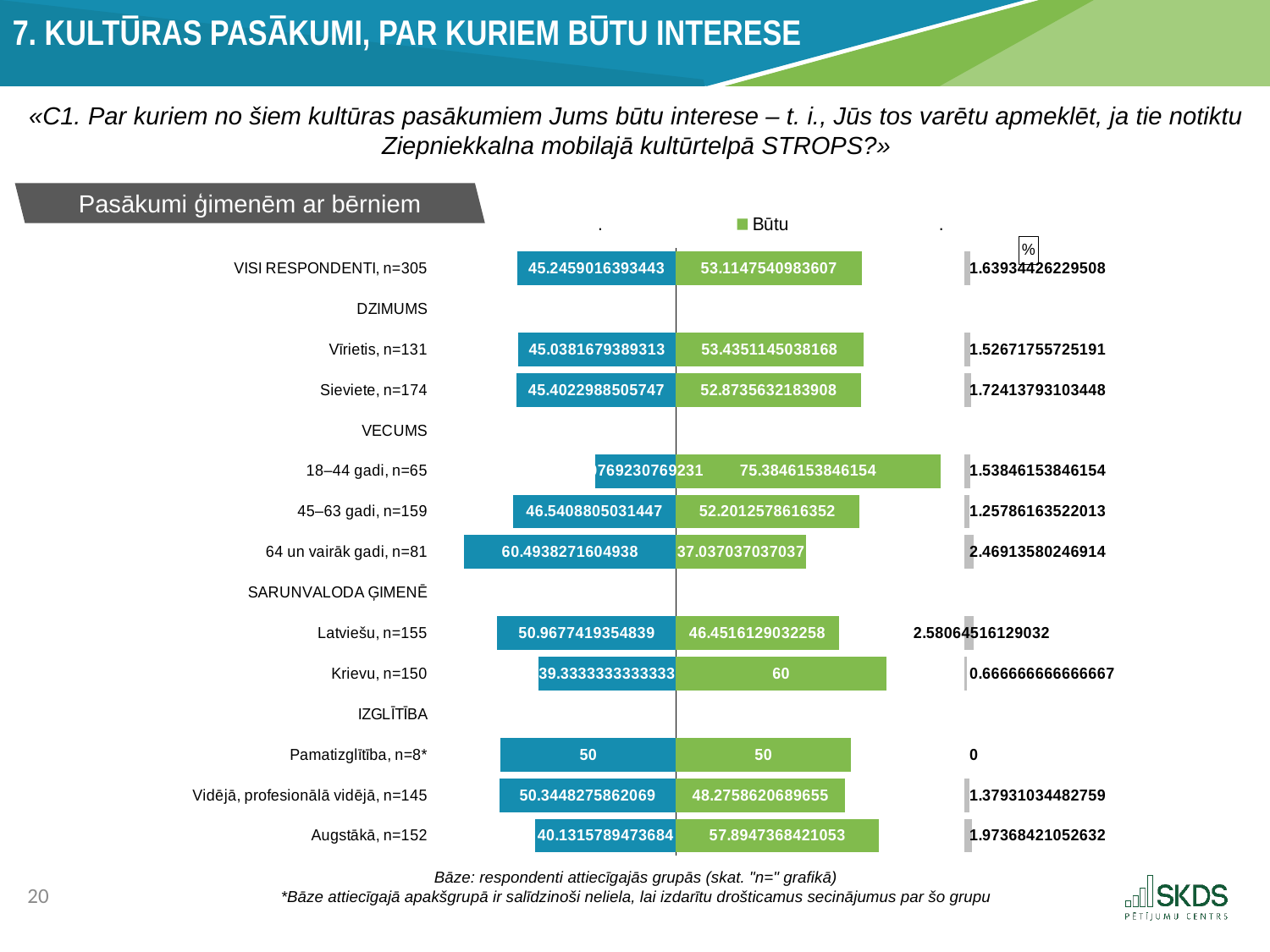
What is the 'Būtu' value for 'Krievu, n=150'? 60 What kind of chart is shown on the slide? bar chart What is the 'Būtu' value for 'VISI RESPONDENTI, n=305'? 53.1147540983607 Which has the larger 'Būtu' value: 'Latviešu, n=155' or 'Krievu, n=150'? Krievu, n=150 How many series does the legend list? 3 Which group has the highest 'Būtu' value? 18–44 gadi, n=65 What is the total of the stacked bar for 'Pamatizglītība, n=8*'? 100 What is the difference between the 'Būtu' values for 'Krievu, n=150' and 'Pamatizglītība, n=8*'? 10 What is the 'Būtu' value for '64 un vairāk gadi, n=81'? 37.037037037037 What is the 'Būtu' value for 'Augstākā, n=152'? 57.8947368421053 How many groups have bars plotted in the chart? 11 Which group has the lowest 'Būtu' value? 64 un vairāk gadi, n=81